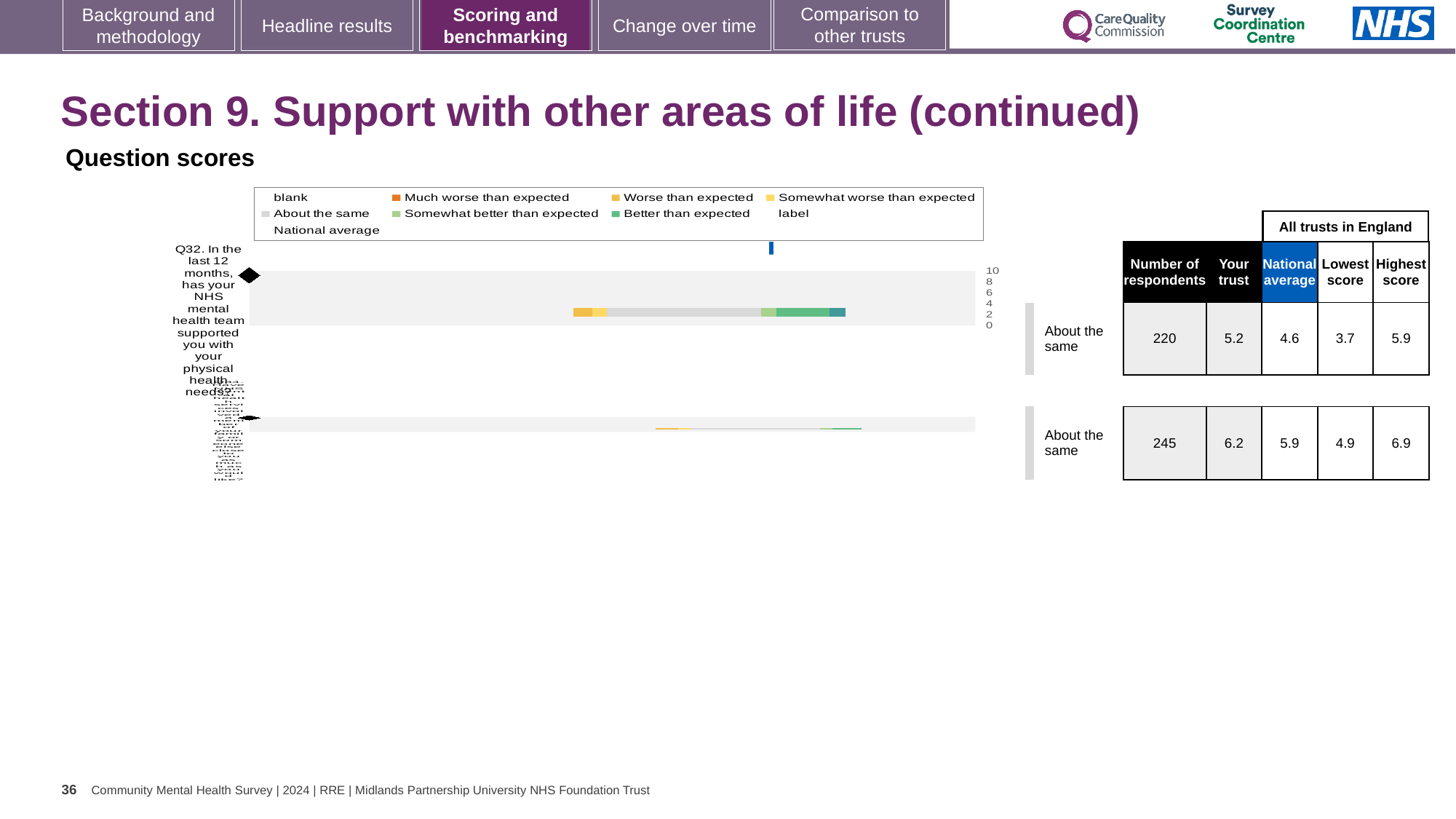
What is the 'Your trust' score for Q32? 5.2 What is the difference between the highest and lowest scores in the second row of the table? 2.0 What is the 'Your trust' score in the second row of the table? 6.2 What benchmark category is shown for Q32 next to the chart? About the same For Q32, is the trust's score higher or lower than the national average? higher What is the number of respondents for Q32 shown in the table? 220 What is the lowest score among all trusts in England for Q32? 3.7 What is the highest score among all trusts in England for Q32? 5.9 What is the number of respondents in the second row of the table? 245 What is the difference between the trust's score and the national average for Q32? 0.6 What is the national average score for Q32? 4.6 What is the maximum value shown on the chart's score axis? 10